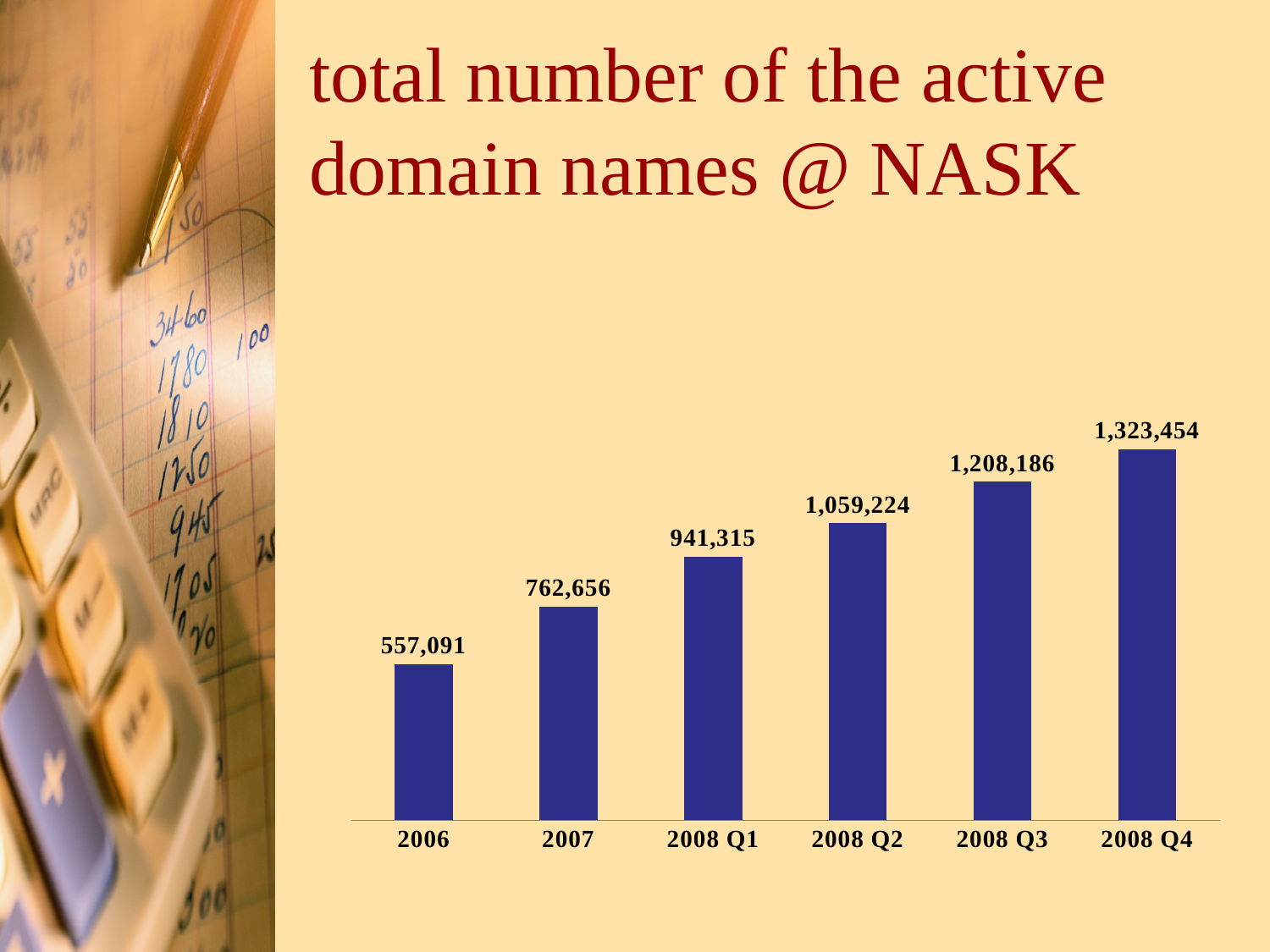
What colour are the bars in the chart? Blue What is the difference between the values for 2007 and 2006? 205,565 What is the number of active domain names for 2008 Q2? 1,059,224 Do the values rise or fall from 2006 to 2008 Q4? Rise Which category has the lowest number of active domain names? 2006 How many categories are shown on the x axis of the chart? 6 Which is larger, the value for 2008 Q1 or the value for 2007? 2008 Q1 What is the number of active domain names for 2006? 557,091 What is the difference between the values for 2008 Q4 and 2008 Q3? 115,268 What kind of chart is shown on the slide? Bar chart What is the number of active domain names for 2008 Q4? 1,323,454 Which category has the highest number of active domain names? 2008 Q4